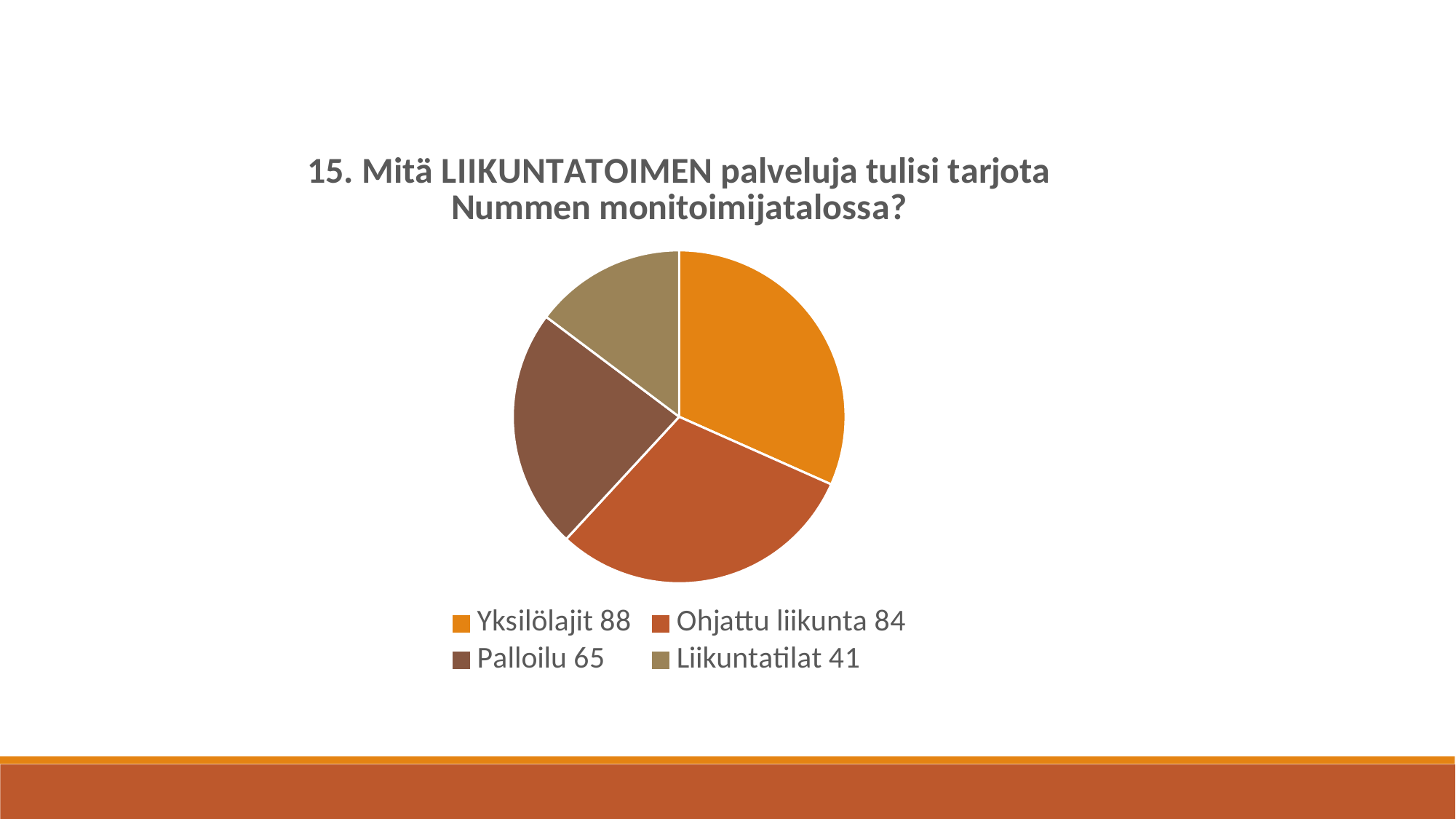
What is the title of the chart? 15. Mitä LIIKUNTATOIMEN palveluja tulisi tarjota Nummen monitoimijatalossa? What kind of chart is shown on the slide? pie chart What is the value for Palloilu? 65 Which is larger, the value for Palloilu or the value for Liikuntatilat? Palloilu Which category has the lowest value? Liikuntatilat What is the value for Yksilölajit? 88 What is the value for Ohjattu liikunta? 84 Which category has the highest value? Yksilölajit What is the difference between the values for Ohjattu liikunta and Palloilu? 19 What is the difference between the values for Yksilölajit and Liikuntatilat? 47 What is the value for Liikuntatilat? 41 How many categories does the pie chart have? 4